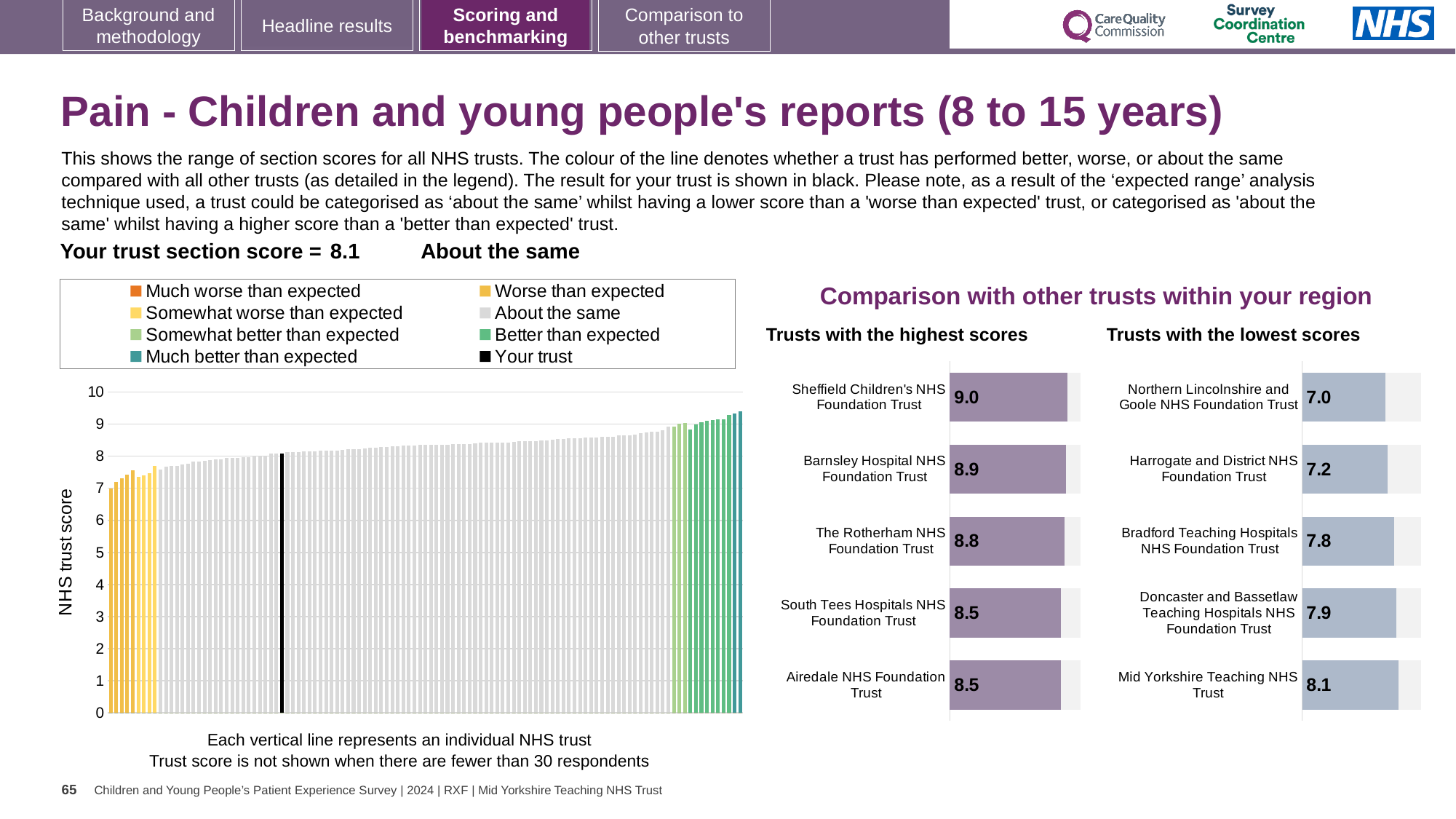
In the 'Trusts with the highest scores' chart, what is the score for Sheffield Children's NHS Foundation Trust? 9.0 In the 'Trusts with the lowest scores' chart, what is the difference between the scores of Mid Yorkshire Teaching NHS Trust and Northern Lincolnshire and Goole NHS Foundation Trust? 1.1 In the 'Trusts with the highest scores' chart, which trust has the highest score? Sheffield Children's NHS Foundation Trust In the 'Trusts with the highest scores' chart, what is the score for The Rotherham NHS Foundation Trust? 8.8 In the 'Trusts with the lowest scores' chart, which trust has the lowest score? Northern Lincolnshire and Goole NHS Foundation Trust In the NHS trust score chart on the left, do the values rise or fall from left to right? Rise How many trusts are shown in the 'Trusts with the highest scores' chart? 5 How many entries does the legend of the NHS trust score chart on the left list? 8 What kind of chart is the NHS trust score chart on the left of the slide? Bar chart In the 'Trusts with the highest scores' chart, what is the difference between the scores of Sheffield Children's NHS Foundation Trust and The Rotherham NHS Foundation Trust? 0.2 In the 'Trusts with the lowest scores' chart, what is the score for Harrogate and District NHS Foundation Trust? 7.2 In the 'Trusts with the lowest scores' chart, which has the higher score: Harrogate and District NHS Foundation Trust or Bradford Teaching Hospitals NHS Foundation Trust? Bradford Teaching Hospitals NHS Foundation Trust